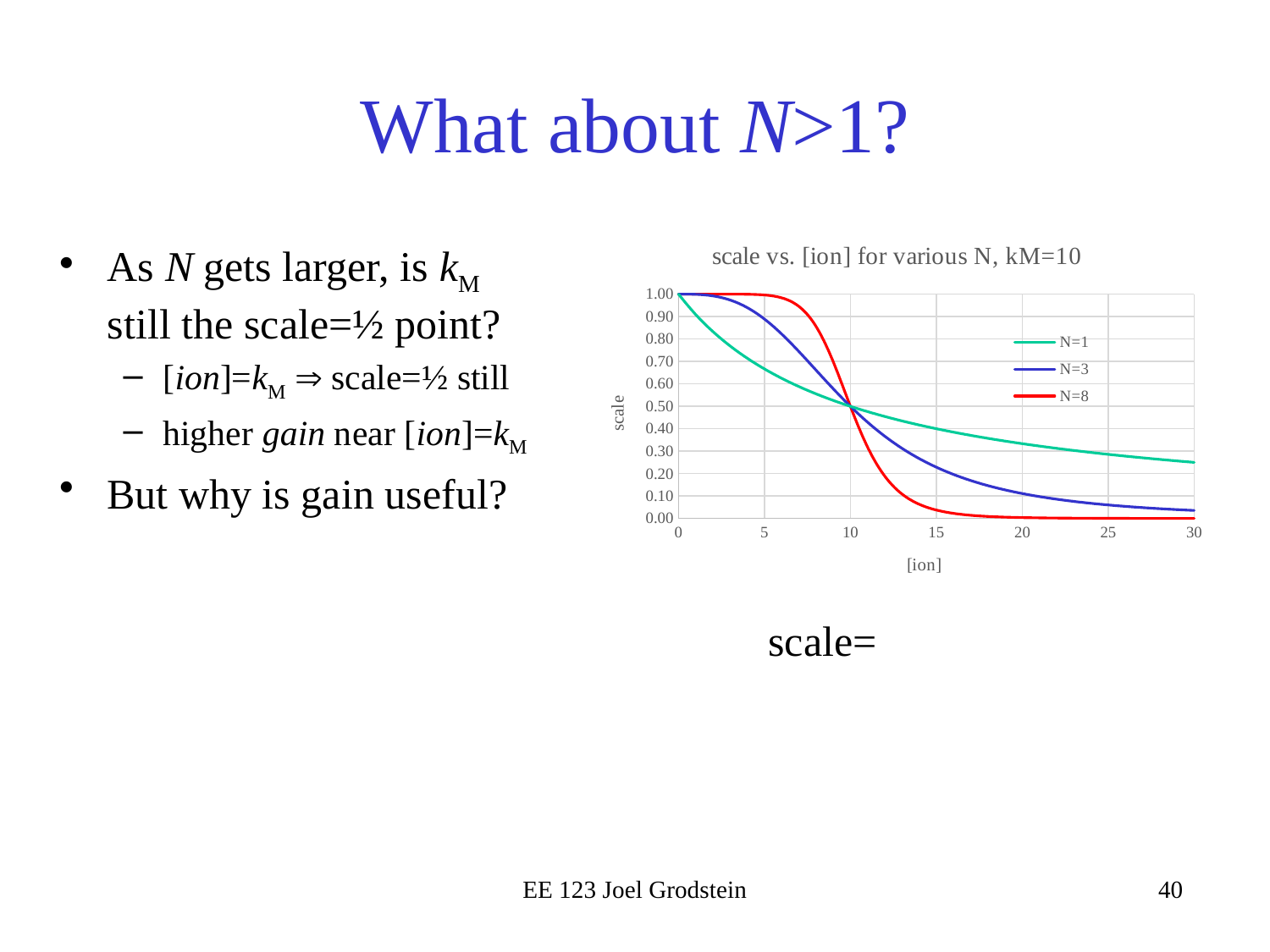
Do the scale values rise or fall as [ion] increases along the x axis? fall Is the scale value for N=8 at [ion]=20 greater or less than 0.10? less Which colour is used for the N=8 series in the chart? red What kind of chart is shown on the slide? line chart What is the scale value of the curves at [ion]=0? 1.00 What is the title of the chart? scale vs. [ion] for various N, kM=10 At [ion]=20, which series has the higher scale value, N=1 or N=8? N=1 At [ion]=5, which series has the higher scale value, N=1 or N=8? N=8 Is the scale value for N=8 at [ion]=5 greater or less than 0.90? greater What scale value do all three curves share at [ion]=10? 0.50 How many series does the chart legend list? 3 Is the scale value for N=1 at [ion]=30 greater or less than 0.20? greater